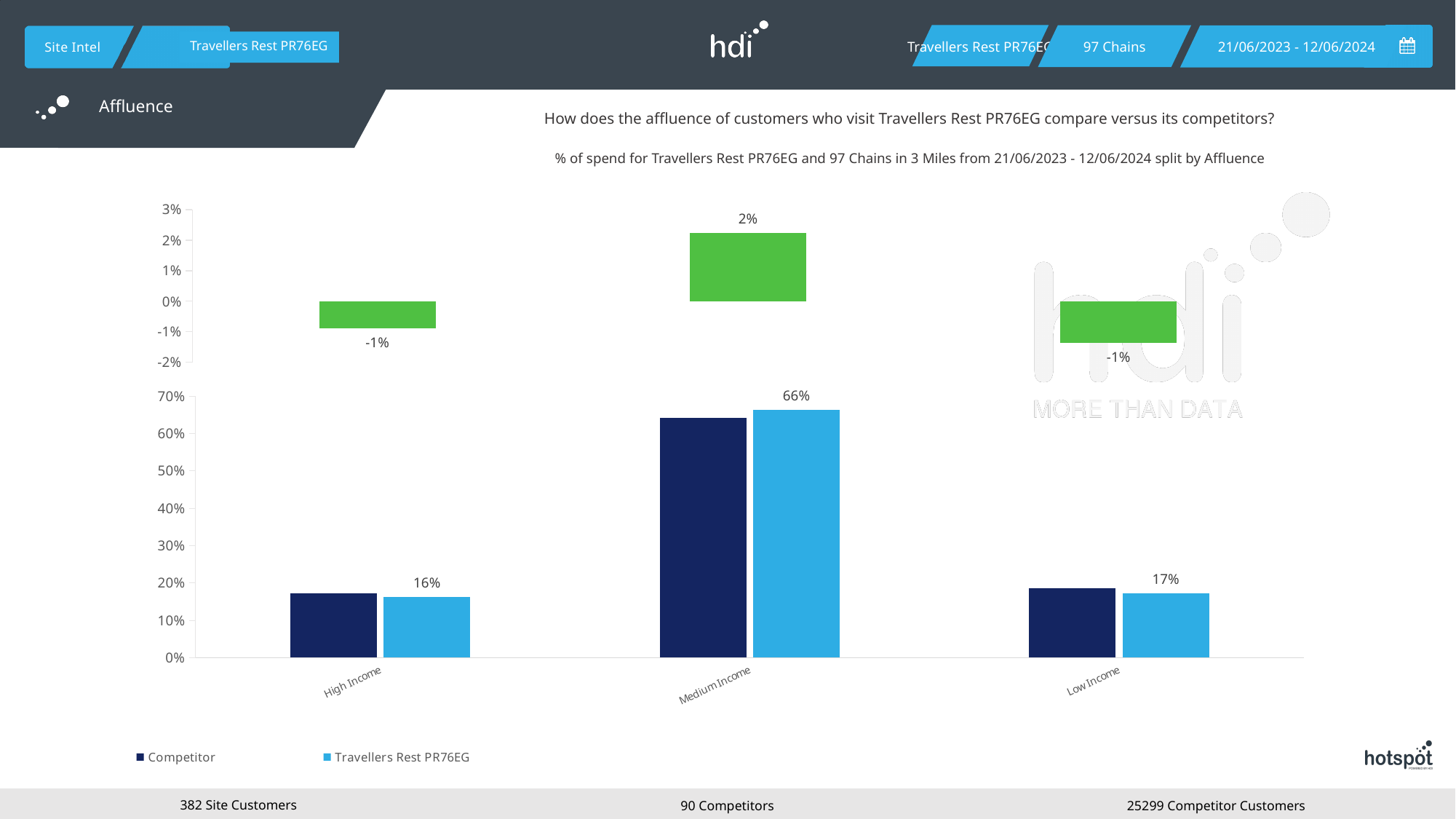
In the top chart, what is the value shown for the High Income category? -1% In the bottom bar chart, what is the value for Travellers Rest PR76EG in the Low Income category? 17% In the bottom bar chart, which category has the highest value for Travellers Rest PR76EG? Medium Income In the top chart, what is the value shown for the Medium Income category? 2% In the bottom bar chart, which category has the lowest value for Travellers Rest PR76EG? High Income In the bottom bar chart, what is the difference between the Travellers Rest PR76EG values for Medium Income and Low Income? 49% What kind of chart is the bottom chart? Bar chart In the bottom bar chart, is the Competitor value for Medium Income greater or less than 60%? greater In the bottom bar chart, is the Competitor value for High Income greater or less than 20%? less In the bottom bar chart, what is the value for Travellers Rest PR76EG in the High Income category? 16% In the bottom bar chart, what is the value for Travellers Rest PR76EG in the Medium Income category? 66% How many series does the legend of the bottom bar chart list? 2